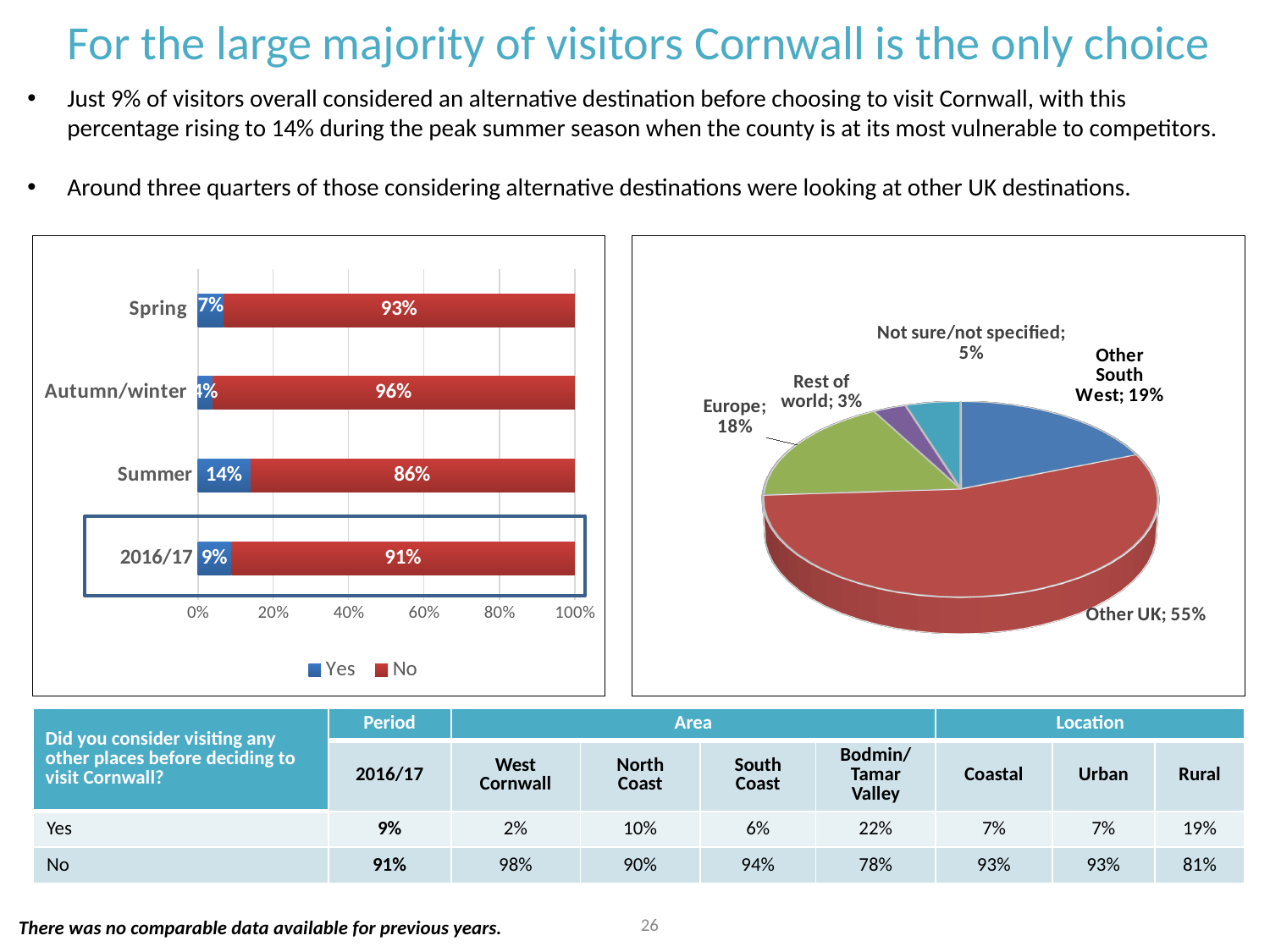
In the bar chart on the left, how many series does the legend list? 2 In the bar chart on the left, how many categories are shown on the vertical axis? 4 In the bar chart on the left, what is the 'Yes' value for Summer? 14% In the bar chart on the left, what is the difference between the 'No' values for Spring and Summer? 7% In the bar chart on the left, which category has the lowest 'Yes' value? Autumn/winter In the pie chart on the right, what share does 'Other UK' have? 55% In the bar chart on the left, which category has the highest 'Yes' value? Summer In the pie chart on the right, which slice is the smallest? Rest of world In the bar chart on the left, what is the 'No' value for Autumn/winter? 96% In the pie chart on the right, which is larger: 'Europe' or 'Other South West'? Other South West What type of chart is shown on the left of the slide? Bar chart In the pie chart on the right, how many slices are there? 5